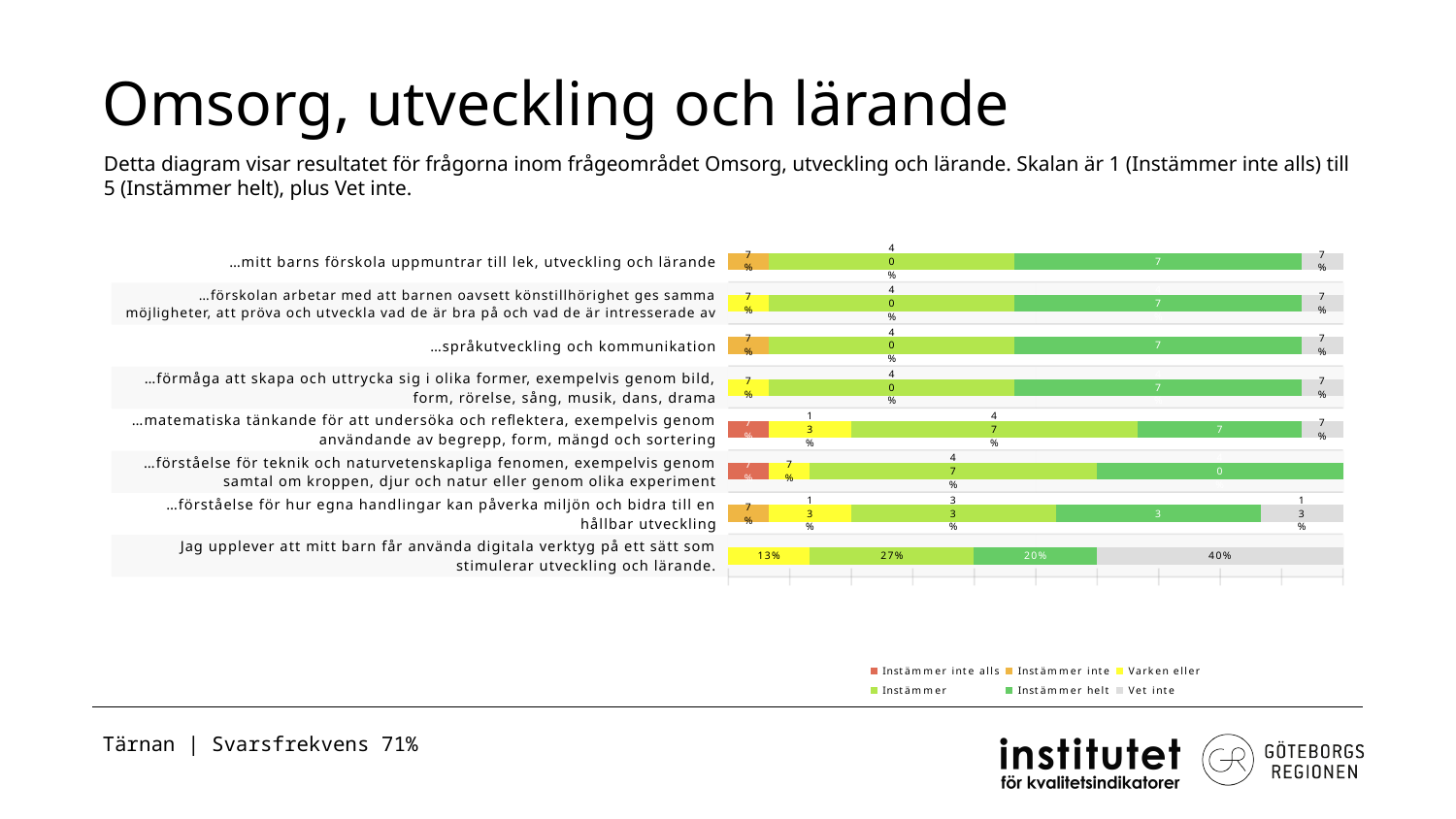
For the statement 'Jag upplever att mitt barn får använda digitala verktyg på ett sätt som stimulerar utveckling och lärande.', what is the value for Vet inte? 40% For the statement 'Jag upplever att mitt barn får använda digitala verktyg på ett sätt som stimulerar utveckling och lärande.', what is the value for Instämmer helt? 20% What is the total of the labelled segments in the bar for the statement about digitala verktyg? 100% For the statement about digitala verktyg, what is the difference between the Vet inte value and the Varken eller value? 27 percentage points How many question statements (categories) are plotted in the chart? 8 For the statement about digitala verktyg, which is larger: Instämmer or Instämmer helt? Instämmer What kind of chart is shown on the slide? Stacked bar chart How many series does the legend list? 6 Which statement has the largest Vet inte segment? Jag upplever att mitt barn får använda digitala verktyg på ett sätt som stimulerar utveckling och lärande. For the statement about digitala verktyg, which response option has the largest share? Vet inte For the statement 'Jag upplever att mitt barn får använda digitala verktyg på ett sätt som stimulerar utveckling och lärande.', what is the value for Instämmer? 27% For the statement 'Jag upplever att mitt barn får använda digitala verktyg på ett sätt som stimulerar utveckling och lärande.', what is the value for Varken eller? 13%